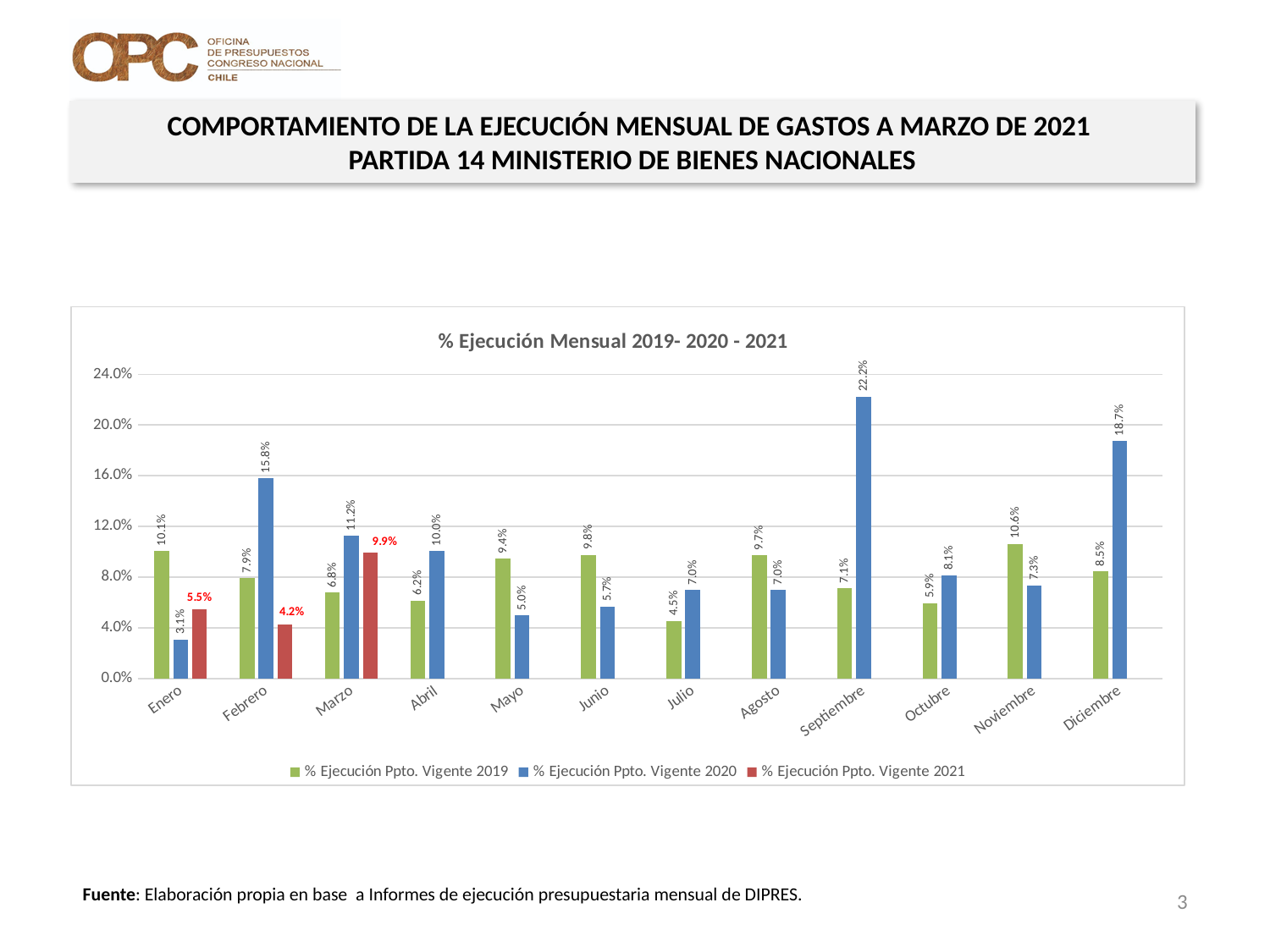
In Enero, which is larger: the 2019 value or the 2020 value? 2019 (10.1%) What is the value for % Ejecución Ppto. Vigente 2021 in Marzo? 9.9% How many months are shown on the x axis? 12 What is the value for % Ejecución Ppto. Vigente 2020 in Febrero? 15.8% In which month is the % Ejecución Ppto. Vigente 2019 series lowest? Julio What is the difference between the 2020 and 2021 values in Marzo? 1.3 percentage points In which month is the % Ejecución Ppto. Vigente 2020 series highest? Septiembre Is the value for % Ejecución Ppto. Vigente 2020 in Diciembre greater or less than 16.0%? greater What is the title of the chart? % Ejecución Mensual 2019- 2020 - 2021 What kind of chart is shown? Bar chart What is the value for % Ejecución Ppto. Vigente 2019 in Noviembre? 10.6% How many series does the legend list? 3